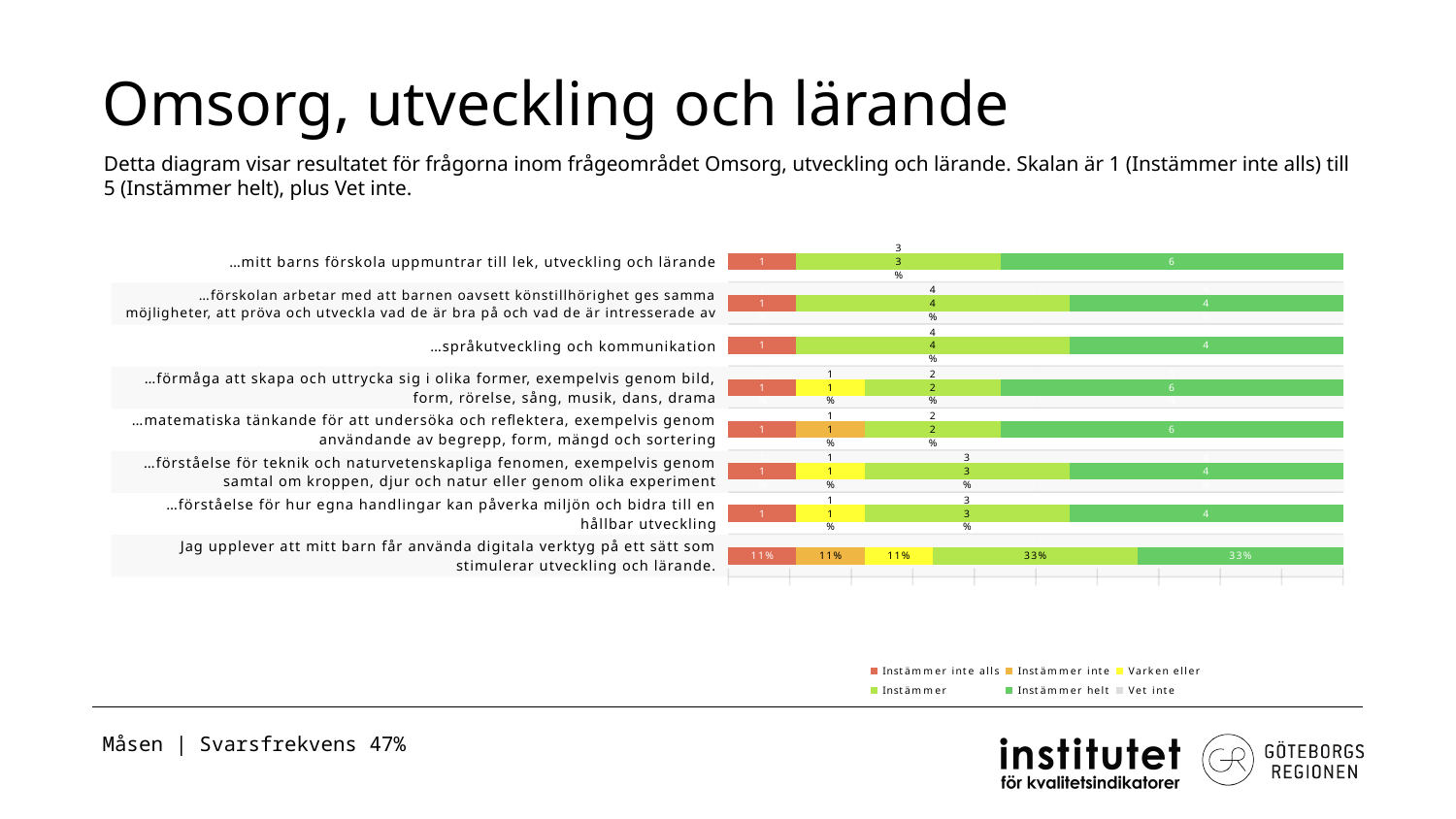
What kind of chart is shown on the slide? Stacked bar chart Which legend entry is shown in red? Instämmer inte alls How many statements (categories) are plotted in the chart? 8 What is the value of the 'Instämmer inte alls' segment for 'Jag upplever att mitt barn får använda digitala verktyg på ett sätt som stimulerar utveckling och lärande.'? 11% What is the value of the 'Instämmer helt' segment for 'Jag upplever att mitt barn får använda digitala verktyg på ett sätt som stimulerar utveckling och lärande.'? 33% How many series does the chart legend list? 6 Which is larger for '…förståelse för teknik och naturvetenskapliga fenomen, exempelvis genom samtal om kroppen, djur och natur eller genom olika experiment': the 'Instämmer' segment or the 'Instämmer helt' segment? Instämmer helt What is the value of the 'Instämmer' segment for '…språkutveckling och kommunikation'? 44%